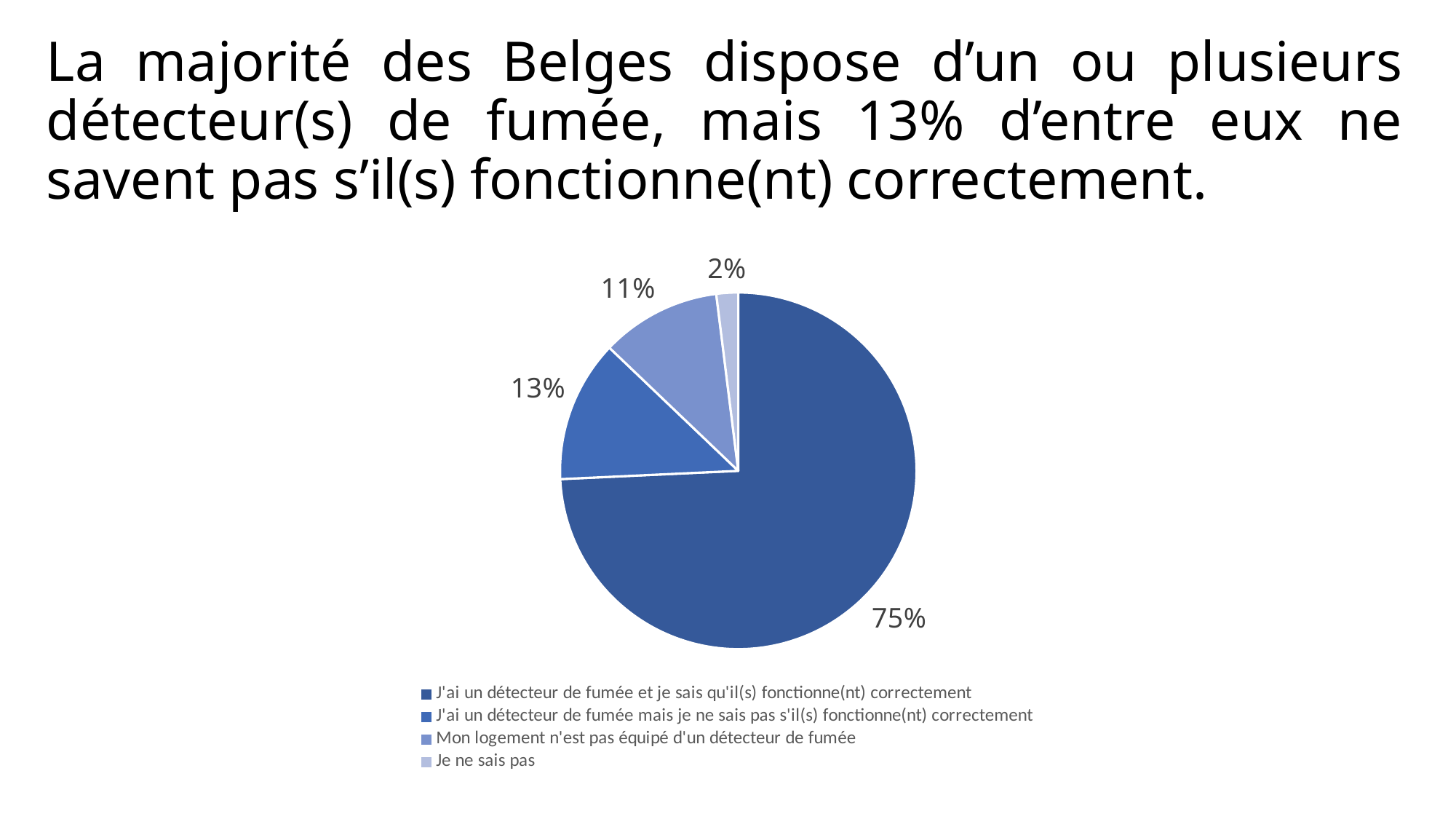
Which category has the smallest slice of the pie? Je ne sais pas How many slices does the pie chart have? 4 What is the difference between the 75% slice and the 13% slice? 62% What share of the pie is labelled for "J'ai un détecteur de fumée mais je ne sais pas s'il(s) fonctionne(nt) correctement"? 13% Which is larger: the slice for "Mon logement n'est pas équipé d'un détecteur de fumée" or the slice for "Je ne sais pas"? Mon logement n'est pas équipé d'un détecteur de fumée How many entries does the legend list? 4 What share of the pie is labelled for "J'ai un détecteur de fumée et je sais qu'il(s) fonctionne(nt) correctement"? 75% What share of the pie is labelled for "Mon logement n'est pas équipé d'un détecteur de fumée"? 11% What share of the pie is labelled for "Je ne sais pas"? 2% What is the combined share of the two slices for respondents who have a smoke detector (75% and 13%)? 88% What kind of chart is shown on the slide? pie chart Which category has the largest slice of the pie? J'ai un détecteur de fumée et je sais qu'il(s) fonctionne(nt) correctement